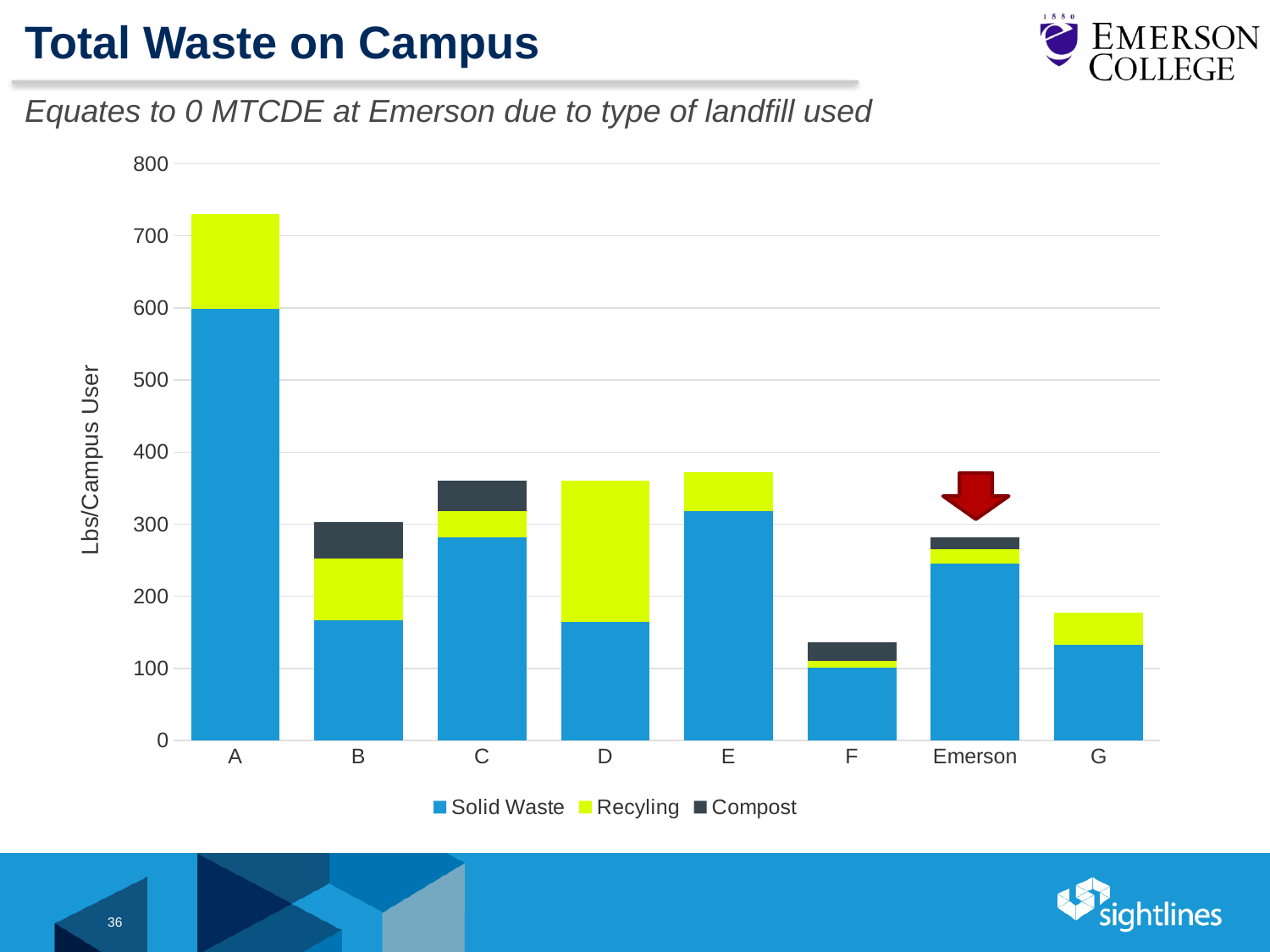
How many series does the legend list? 3 Is the total value for Emerson greater or less than 300? less Is the total value for D greater or less than 300? greater Which has a larger total, D or G? D How many categories are shown along the x axis? 8 Which category has the largest Solid Waste segment? A Which category has the highest total waste per campus user? A What kind of chart is shown on the slide? Stacked bar chart Is the total value for A greater or less than 700? greater What is the label on the y axis? Lbs/Campus User Which category has the lowest total waste per campus user? F